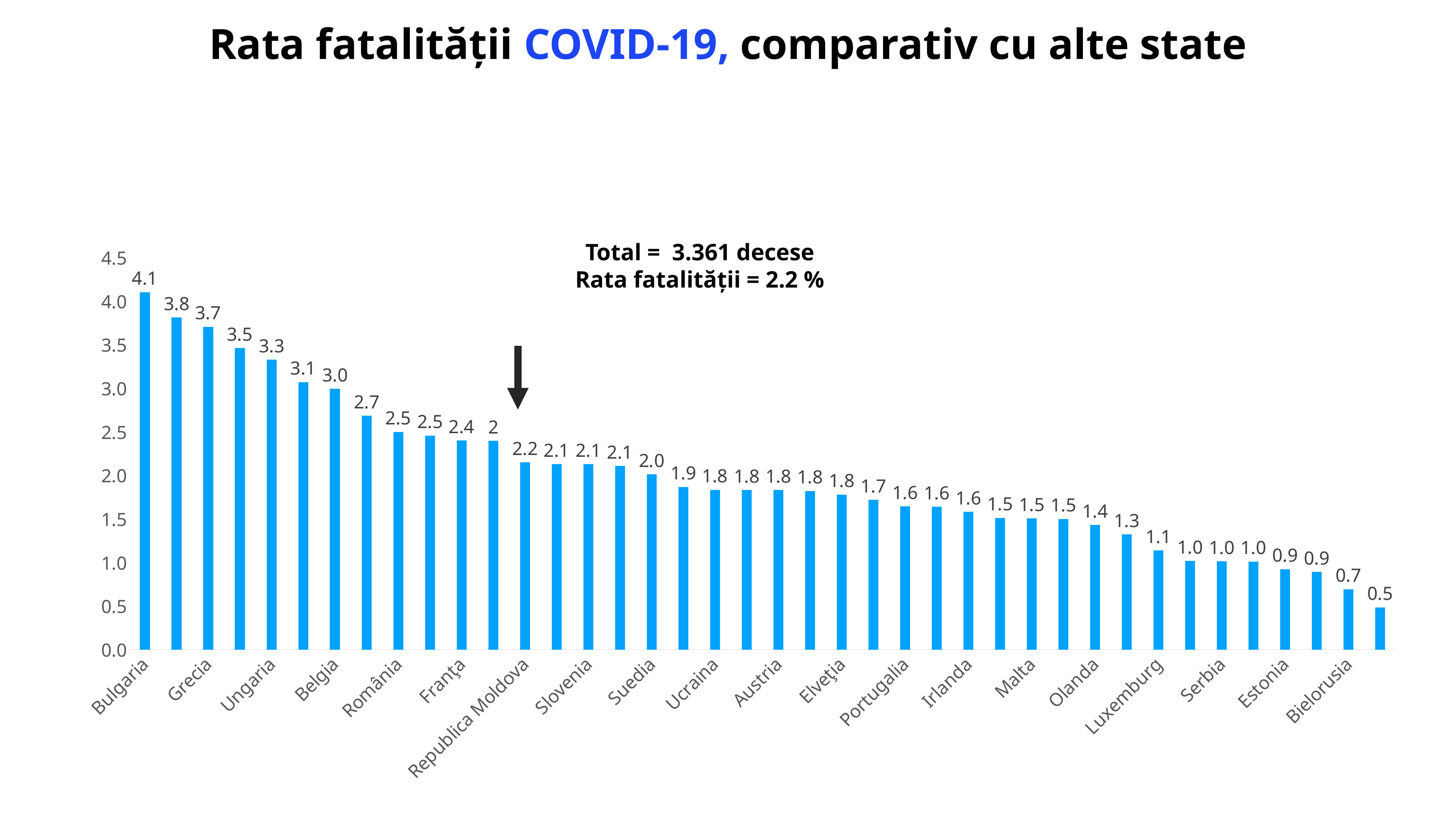
What is the fatality rate value shown for Bielorusia? 0.7 What is the fatality rate value shown for Republica Moldova? 2.2 Is the value for Serbia greater or less than 1.5? less What type of chart is shown on the slide? bar chart What total number of deaths is stated in the text above the chart? 3.361 decese Do the values rise or fall from left to right along the x axis? fall What is the fatality rate value shown for Bulgaria? 4.1 What is the fatality rate value shown for Grecia? 3.7 Which labelled country has the highest fatality rate in the chart? Bulgaria What is the fatality rate value shown for Belgia? 3.0 Which has a higher fatality rate, Grecia or Ungaria? Grecia What is the difference between the fatality rate of Bulgaria and that of Republica Moldova? 1.9